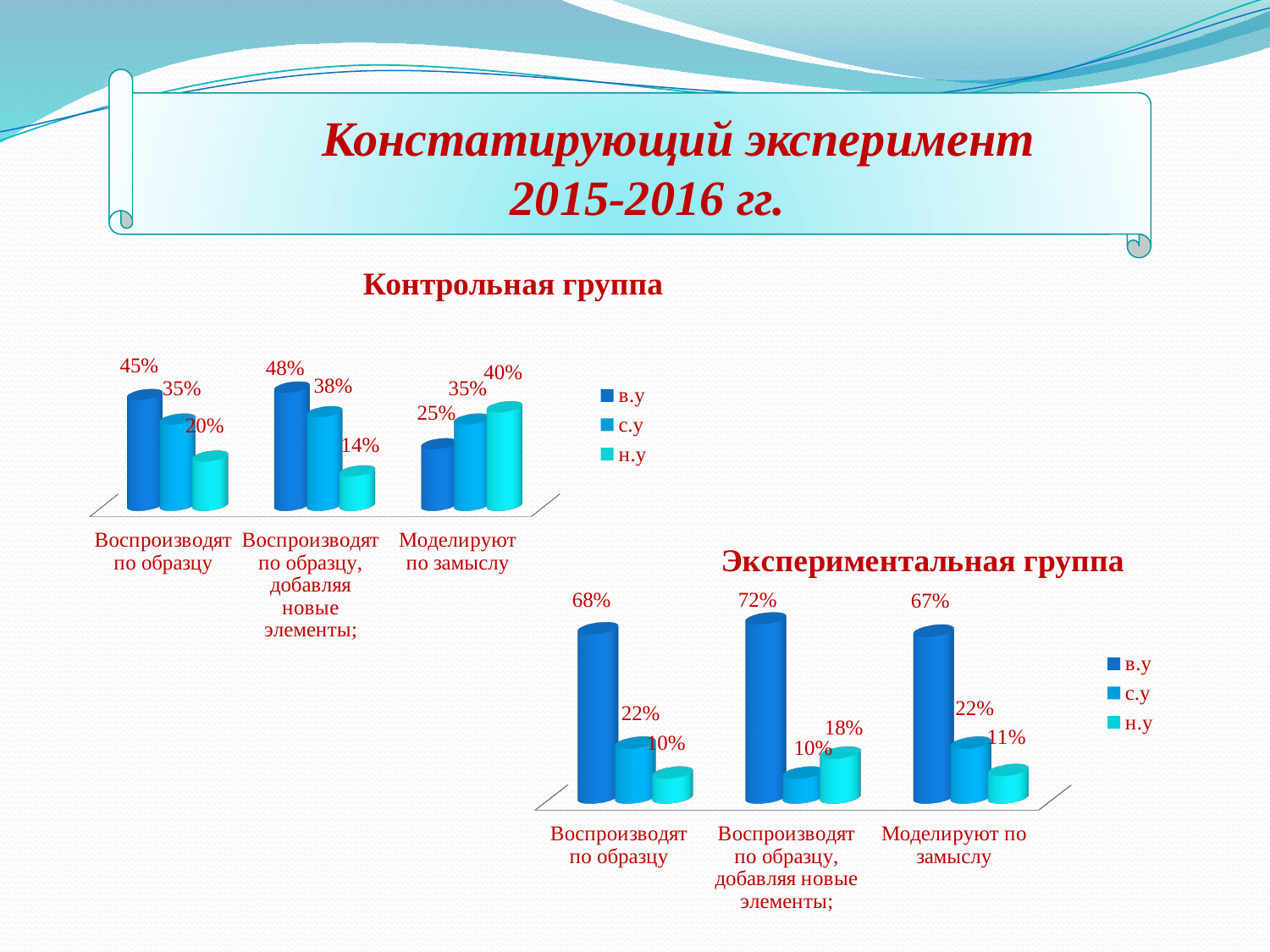
In the 'Экспериментальная группа' chart, what is the difference between the в.у and с.у values for 'Воспроизводят по образцу'? 46% What type of chart is the 'Экспериментальная группа' chart? Bar chart In the 'Экспериментальная группа' chart, what is the value of в.у for 'Воспроизводят по образцу, добавляя новые элементы'? 72% In the 'Экспериментальная группа' chart, which category has the highest в.у value? Воспроизводят по образцу, добавляя новые элементы How many categories are shown on the x axis of the 'Контрольная группа' chart? 3 In the 'Контрольная группа' chart, which is larger for 'Моделируют по замыслу': в.у or н.у? н.у In the 'Контрольная группа' chart, what is the value of в.у for 'Воспроизводят по образцу'? 45% How many series does the legend of the 'Экспериментальная группа' chart list? 3 In the 'Контрольная группа' chart, what is the value of с.у for 'Воспроизводят по образцу, добавляя новые элементы'? 38% In the 'Контрольная группа' chart, what is the value of н.у for 'Моделируют по замыслу'? 40% In the 'Контрольная группа' chart, which category has the lowest н.у value? Воспроизводят по образцу, добавляя новые элементы In the 'Экспериментальная группа' chart, what is the value of н.у for 'Моделируют по замыслу'? 11%